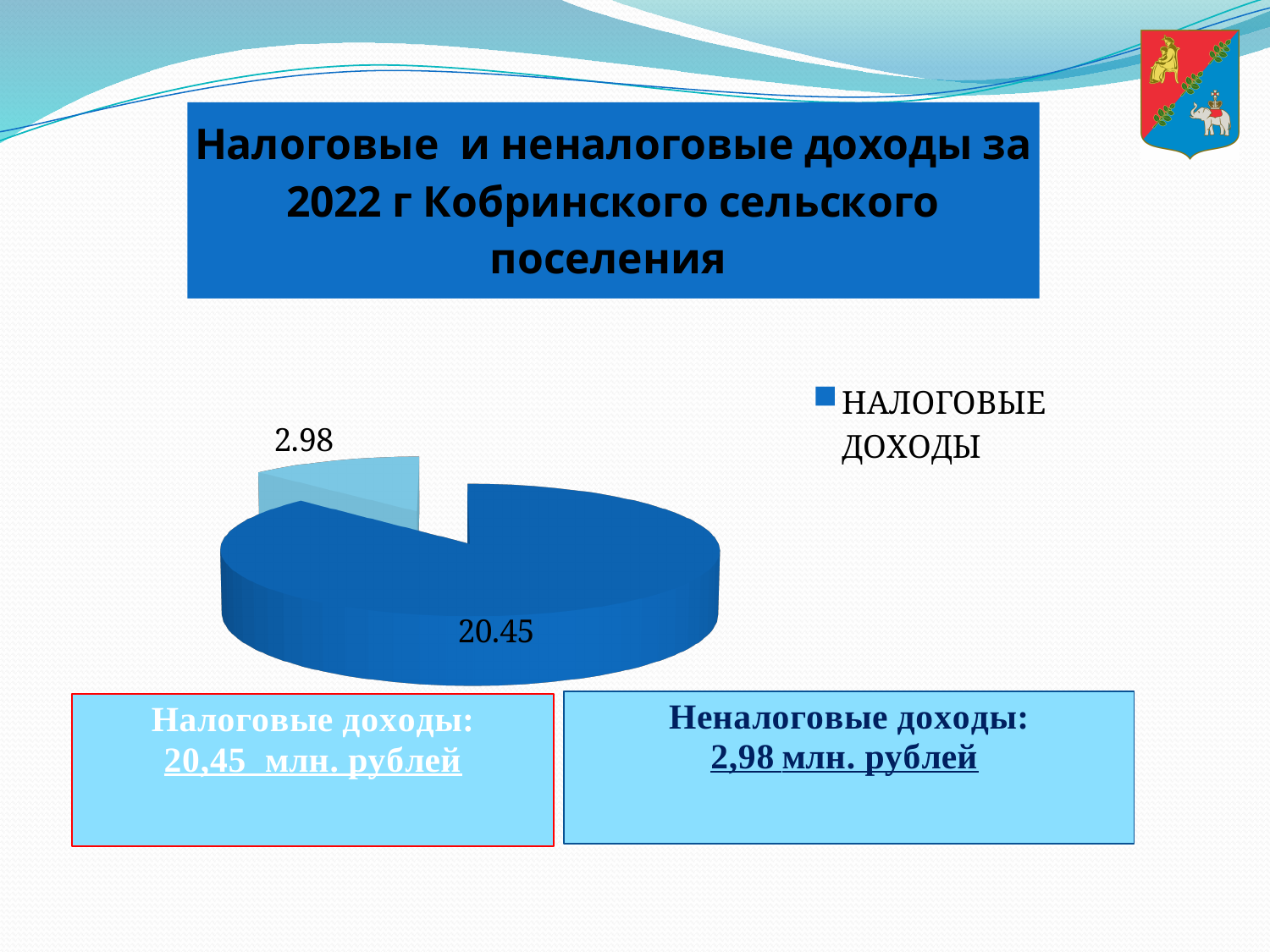
How many slices does the pie chart have? 2 What value is labelled on the small light-blue slice of the pie chart? 2.98 What is the total of the two slice values shown in the pie chart? 23.43 Which slice of the pie chart is the largest? НАЛОГОВЫЕ ДОХОДЫ (20.45) What is the difference between the two slice values in the pie chart (20.45 and 2.98)? 17.47 What kind of chart is shown on the slide? Pie chart What value is labelled on the НАЛОГОВЫЕ ДОХОДЫ slice of the pie chart? 20.45 Which is larger in the pie chart: the slice labelled 20.45 or the slice labelled 2.98? The slice labelled 20.45 What is the value of the smallest slice in the pie chart? 2.98 How many entries does the legend of the pie chart list? 1 What share of the pie does the slice labelled 20.45 represent, to one decimal place? 87.3% What colour is the НАЛОГОВЫЕ ДОХОДЫ slice in the pie chart? Dark blue